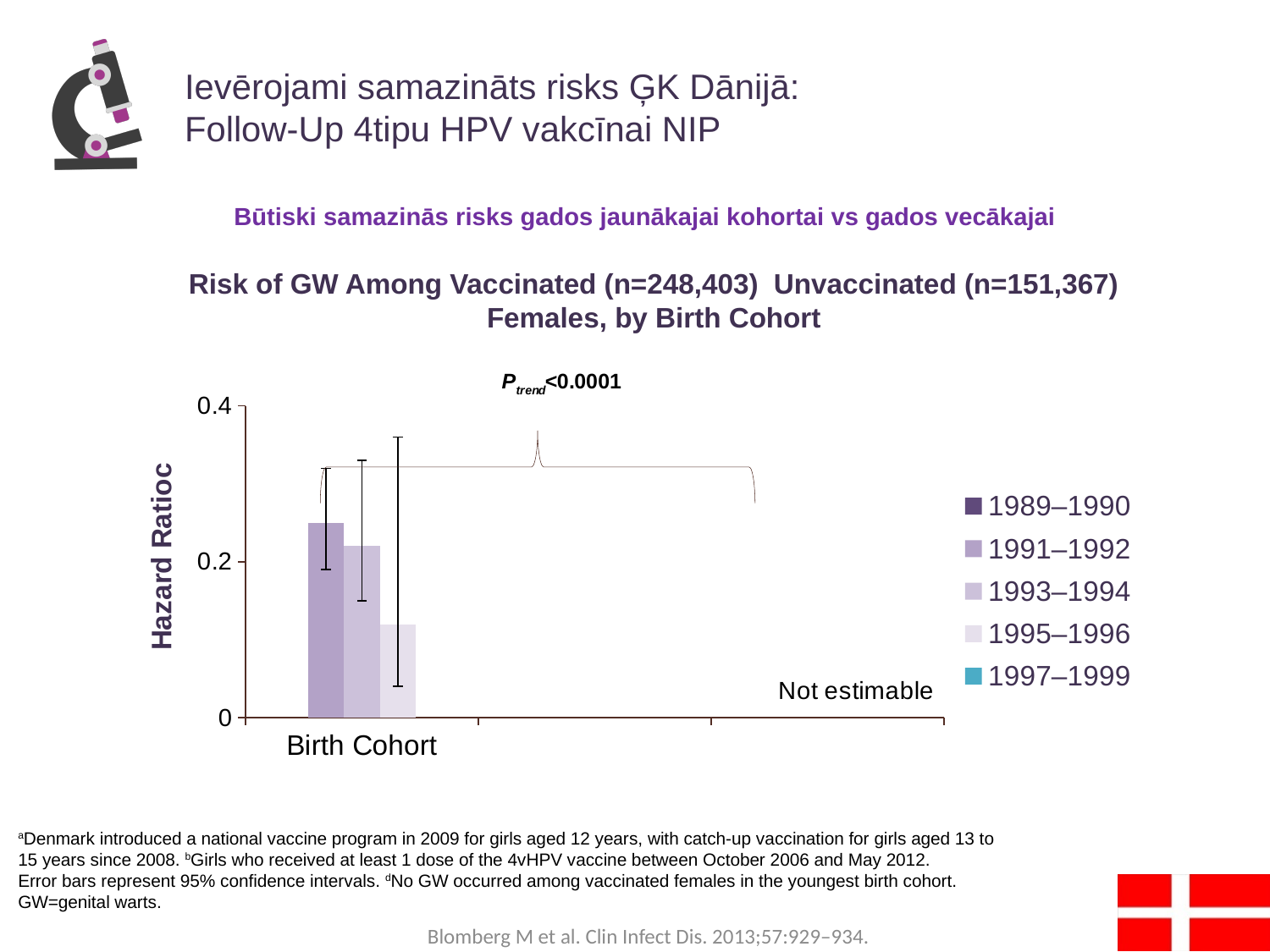
What kind of chart is shown on the slide? Bar chart Which birth cohort has the highest hazard ratio among the plotted bars? 1991–1992 What is the label of the vertical axis? Hazard Ratio How many series does the legend list? 5 What P trend value is shown above the chart? <0.0001 Is the hazard ratio for the 1991–1992 cohort greater or less than 0.4? less How many bars are plotted on the chart? 3 Which birth cohort has the lowest hazard ratio among the plotted bars? 1995–1996